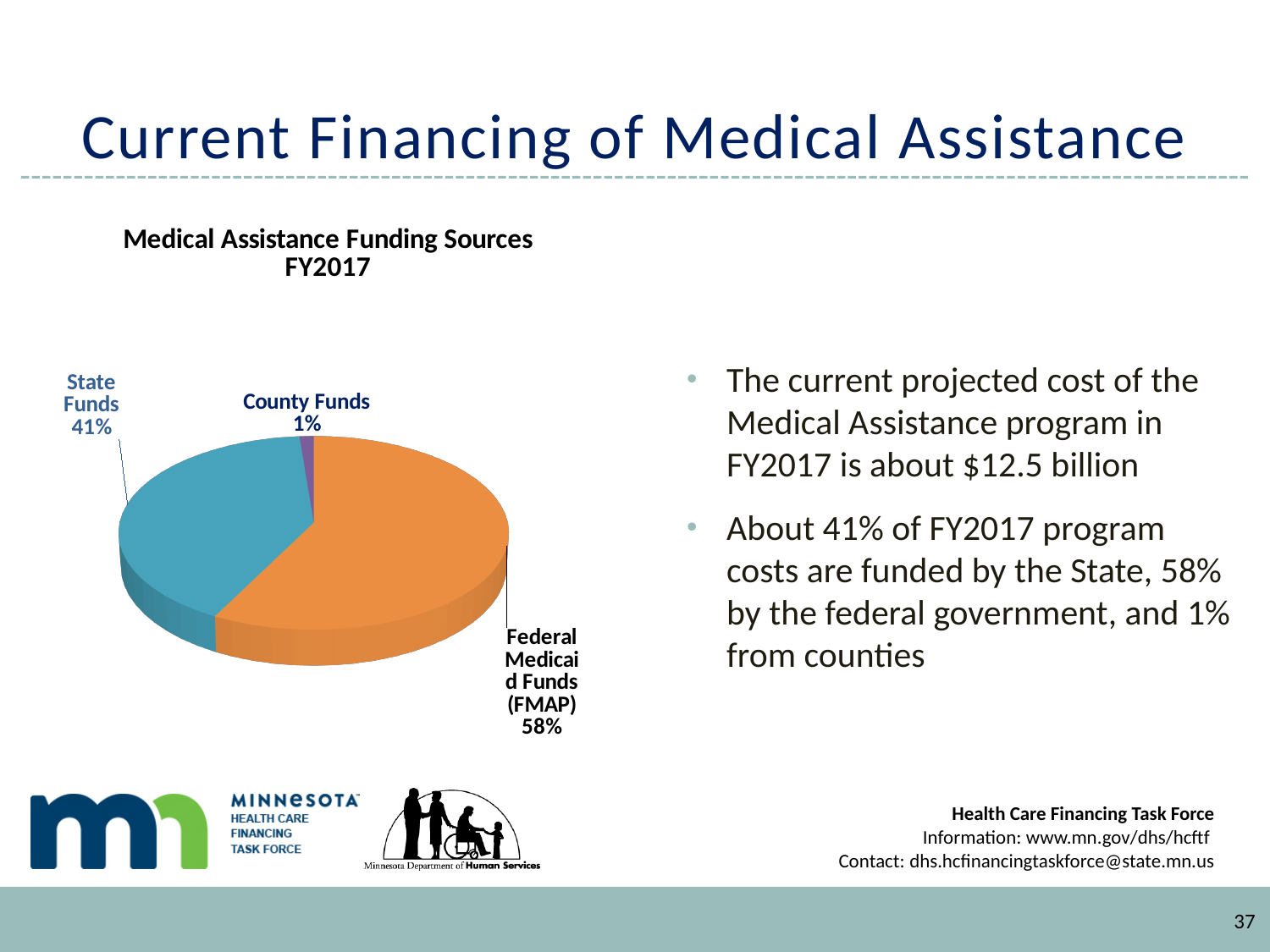
Which is larger, the share for State Funds or the share for County Funds? State Funds What colour is the slice for Federal Medicaid Funds (FMAP)? Orange Which funding source has the largest share of the pie? Federal Medicaid Funds (FMAP) What share of Medical Assistance funding comes from State Funds? 41% What share of Medical Assistance funding comes from County Funds? 1% What is the title of the chart? Medical Assistance Funding Sources FY2017 Which funding source has the smallest share of the pie? County Funds What is the combined share of State Funds and County Funds? 42% What is the difference in percentage points between Federal Medicaid Funds (FMAP) and State Funds? 17 What share of Medical Assistance funding comes from Federal Medicaid Funds (FMAP)? 58% How many slices does the pie chart have? 3 What type of chart is shown on the slide? Pie chart